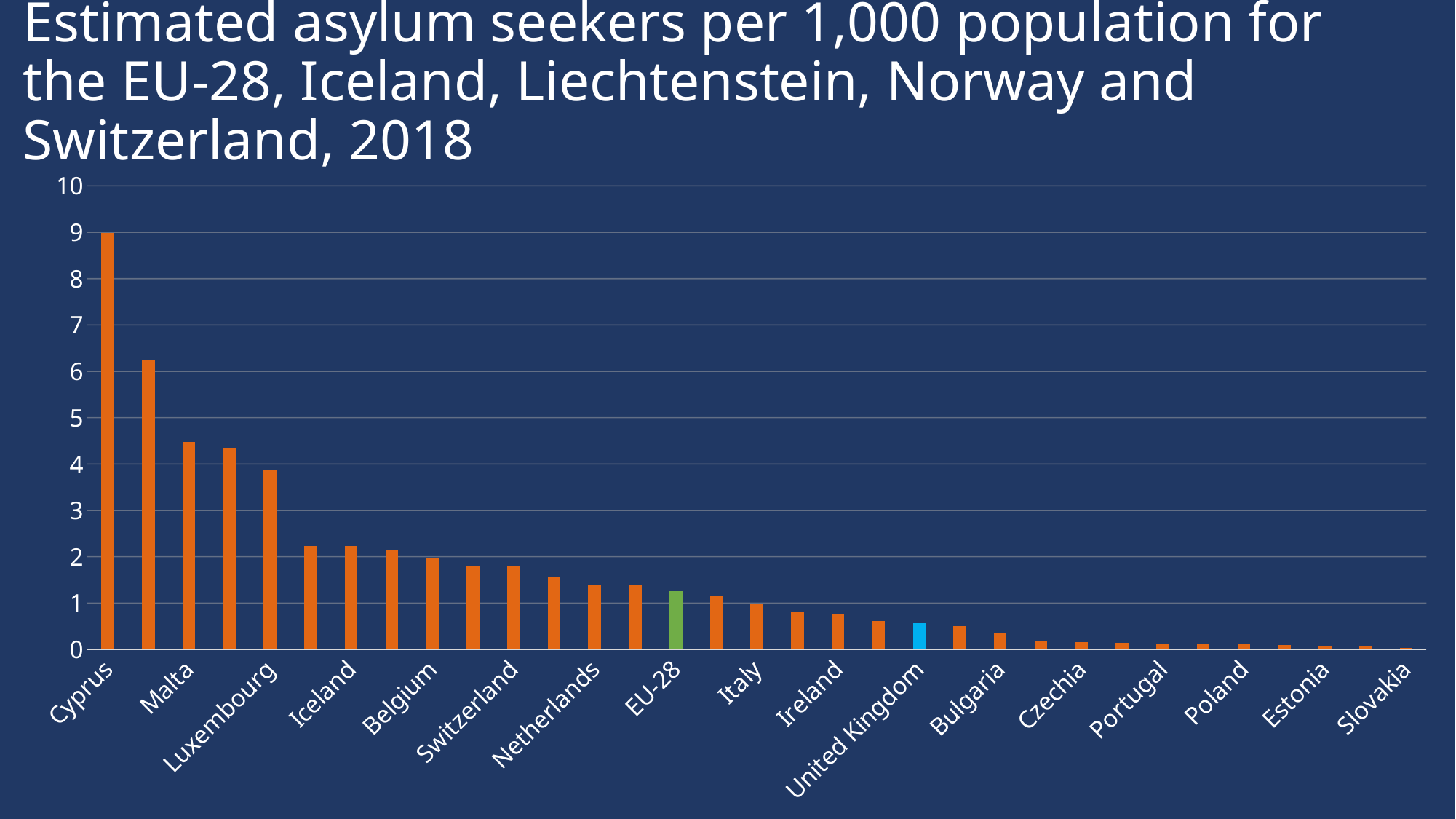
Which is larger, the value for Iceland or the value for Ireland? Iceland Which category has the lowest value? Slovakia Is the value for Ireland greater or less than 1? less Is the value for Malta greater or less than 5? less Is the value for EU-28 greater or less than 1? greater What colour is the bar for EU-28? green Which category has the highest value? Cyprus Do the values rise or fall moving from left to right along the x axis? fall What kind of chart is shown on the slide? bar chart